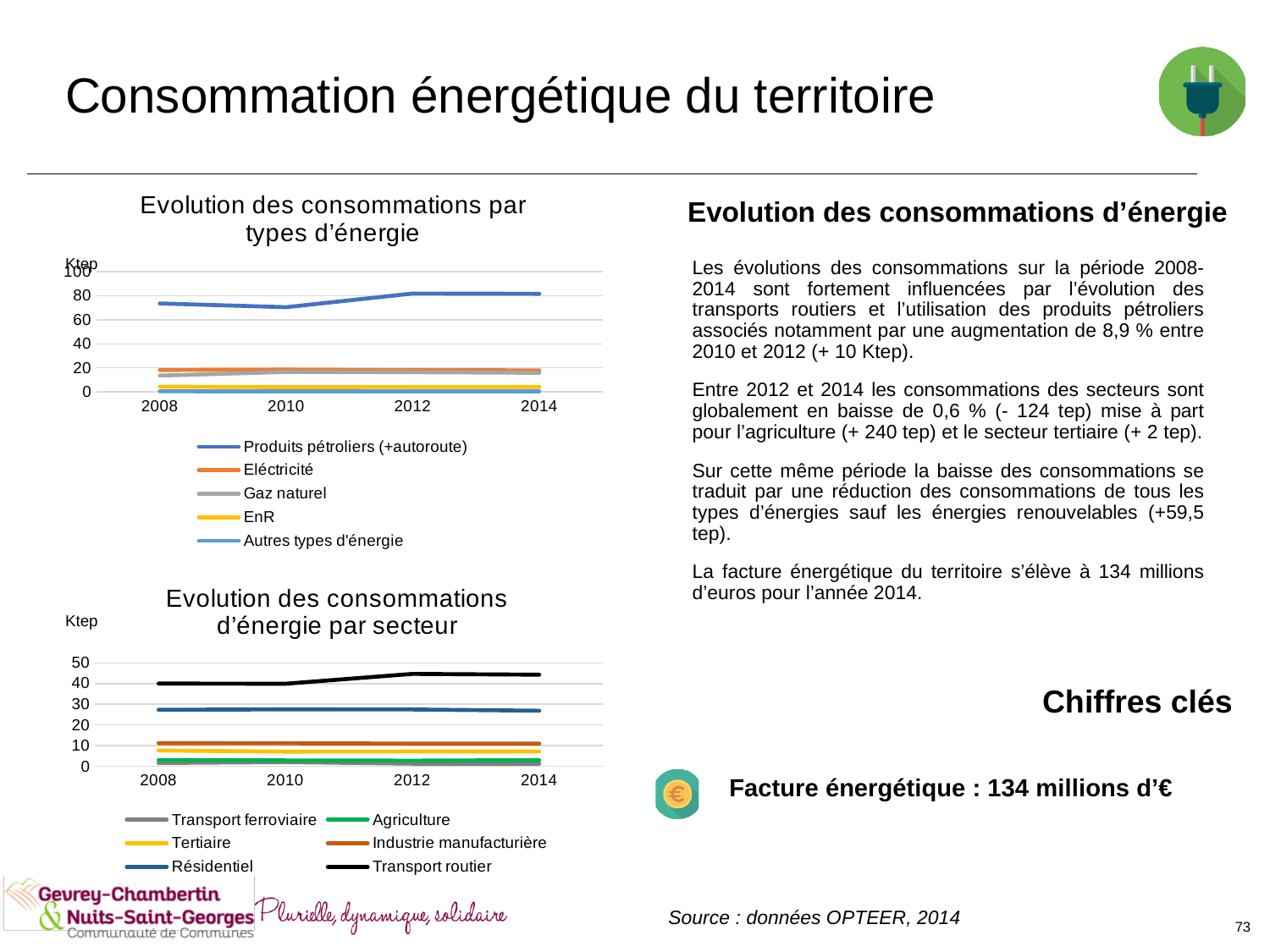
In the bottom chart, 'Evolution des consommations d'énergie par secteur', which sector has the highest consumption? Transport routier How many series does the legend of the top chart, 'Evolution des consommations par types d'énergie', list? 5 What kind of chart is the top chart, 'Evolution des consommations par types d'énergie'? line chart In the top chart, 'Evolution des consommations par types d'énergie', is the value for Eléctricité in 2014 greater or less than 40? less In the top chart, 'Evolution des consommations par types d'énergie', which energy type has the highest consumption? Produits pétroliers (+autoroute) What unit is shown on the y axis of the top chart, 'Evolution des consommations par types d'énergie'? Ktep In the top chart, 'Evolution des consommations par types d'énergie', is the value for Produits pétroliers (+autoroute) in 2008 greater or less than 60? greater How many years are plotted on the x axis of the top chart, 'Evolution des consommations par types d'énergie'? 4 In the bottom chart, 'Evolution des consommations d'énergie par secteur', is the value for Résidentiel in 2012 greater or less than 20? greater In the bottom chart, 'Evolution des consommations d'énergie par secteur', which is larger in 2014, Résidentiel or Industrie manufacturière? Résidentiel How many series does the legend of the bottom chart, 'Evolution des consommations d'énergie par secteur', list? 6 In the top chart, 'Evolution des consommations par types d'énergie', does the Produits pétroliers (+autoroute) line rise or fall between 2010 and 2012? rise